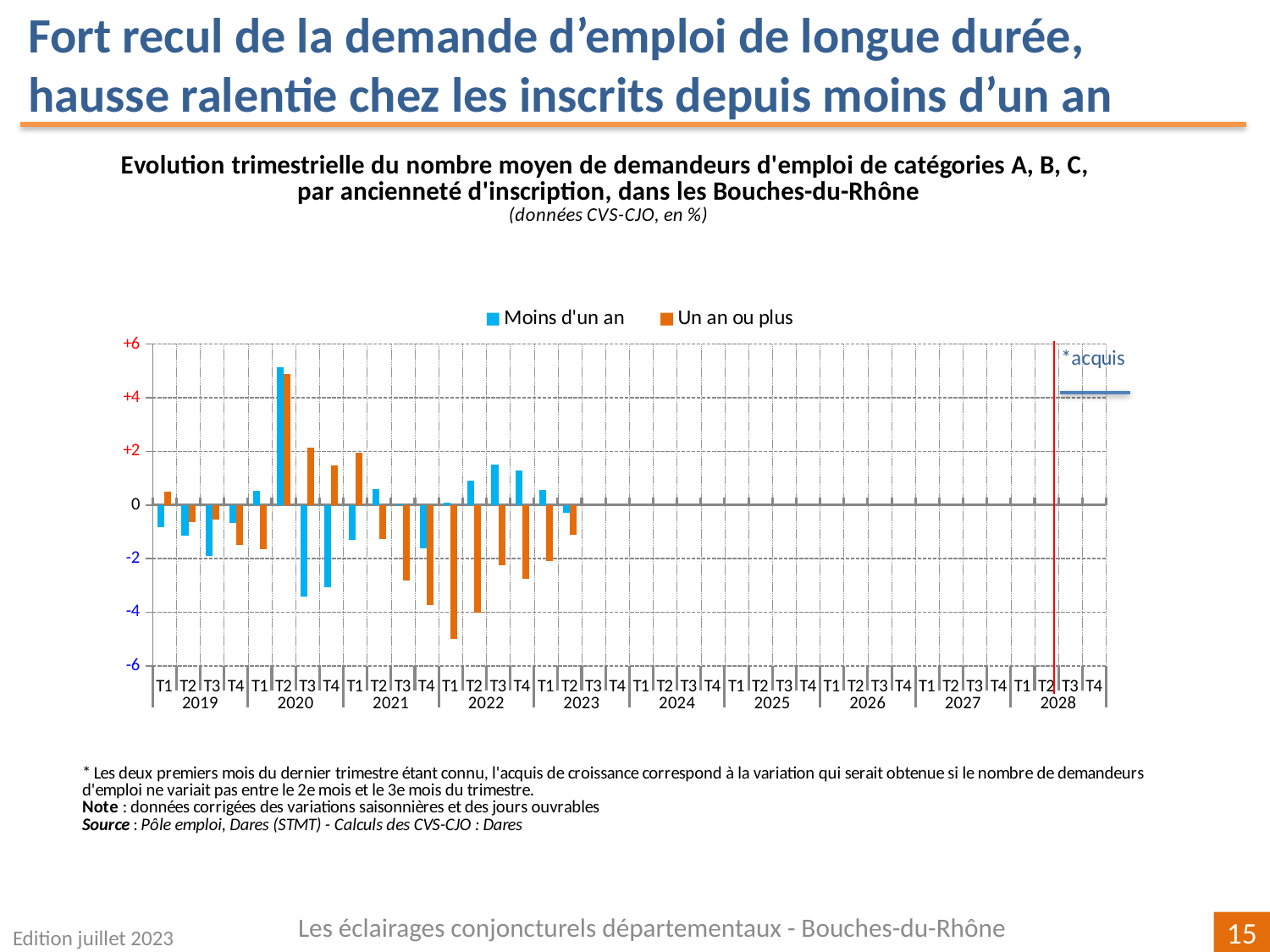
How many series does the legend list? 2 Does the 'Un an ou plus' series rise or fall from T2 2020 to T4 2020? fall In which quarter does the 'Moins d'un an' series reach its highest value? T2 2020 In T1 2022, which series has the larger value, 'Moins d'un an' or 'Un an ou plus'? Moins d'un an What kind of chart is shown on the slide? bar chart Is the value for 'Moins d'un an' in T2 2020 greater or less than +4? greater In T3 2020, which series has the larger value, 'Moins d'un an' or 'Un an ou plus'? Un an ou plus Is the value for 'Moins d'un an' in T3 2020 greater or less than -2? less What are the two series named in the legend? Moins d'un an; Un an ou plus In which quarter does the 'Un an ou plus' series reach its lowest value? T1 2022 What label appears next to the vertical red line at the right of the chart? *acquis Is the value for 'Un an ou plus' in T1 2022 greater or less than -4? less